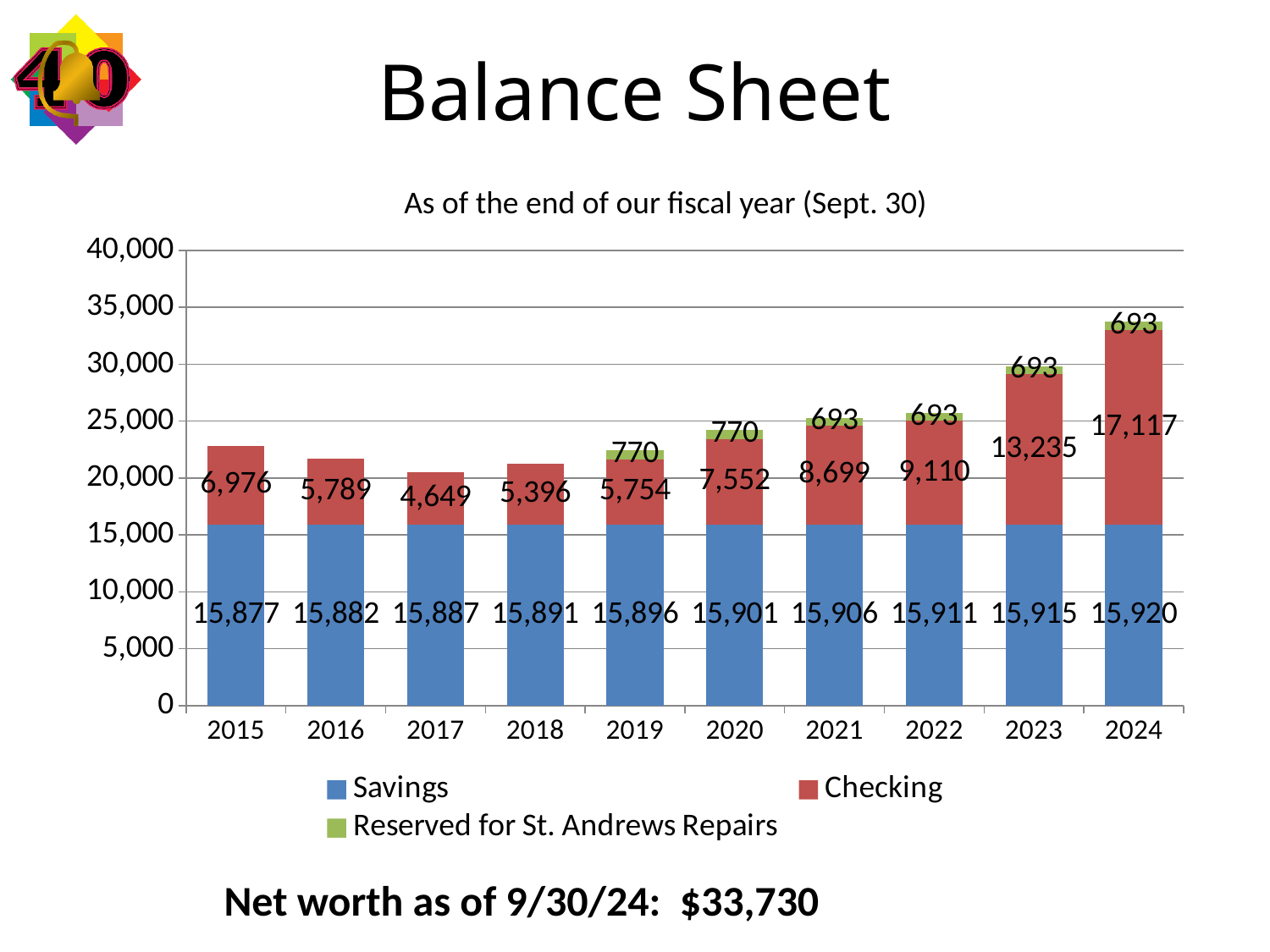
What is the difference between the Checking values for 2024 and 2023? 3,882 What is the Checking value for 2024? 17,117 What is the total of the stacked bar for 2024? 33,730 Which year has the highest Checking value? 2024 What type of chart is shown on the slide? Stacked bar chart Is the Checking value larger in 2021 or in 2018? 2021 Which year has the lowest Checking value? 2017 What is the Reserved for St. Andrews Repairs value for 2019? 770 How many series does the legend list? 3 What is the Savings value for 2015? 15,877 Do the Savings values rise or fall from 2015 to 2024? Rise How many years are shown on the x axis? 10